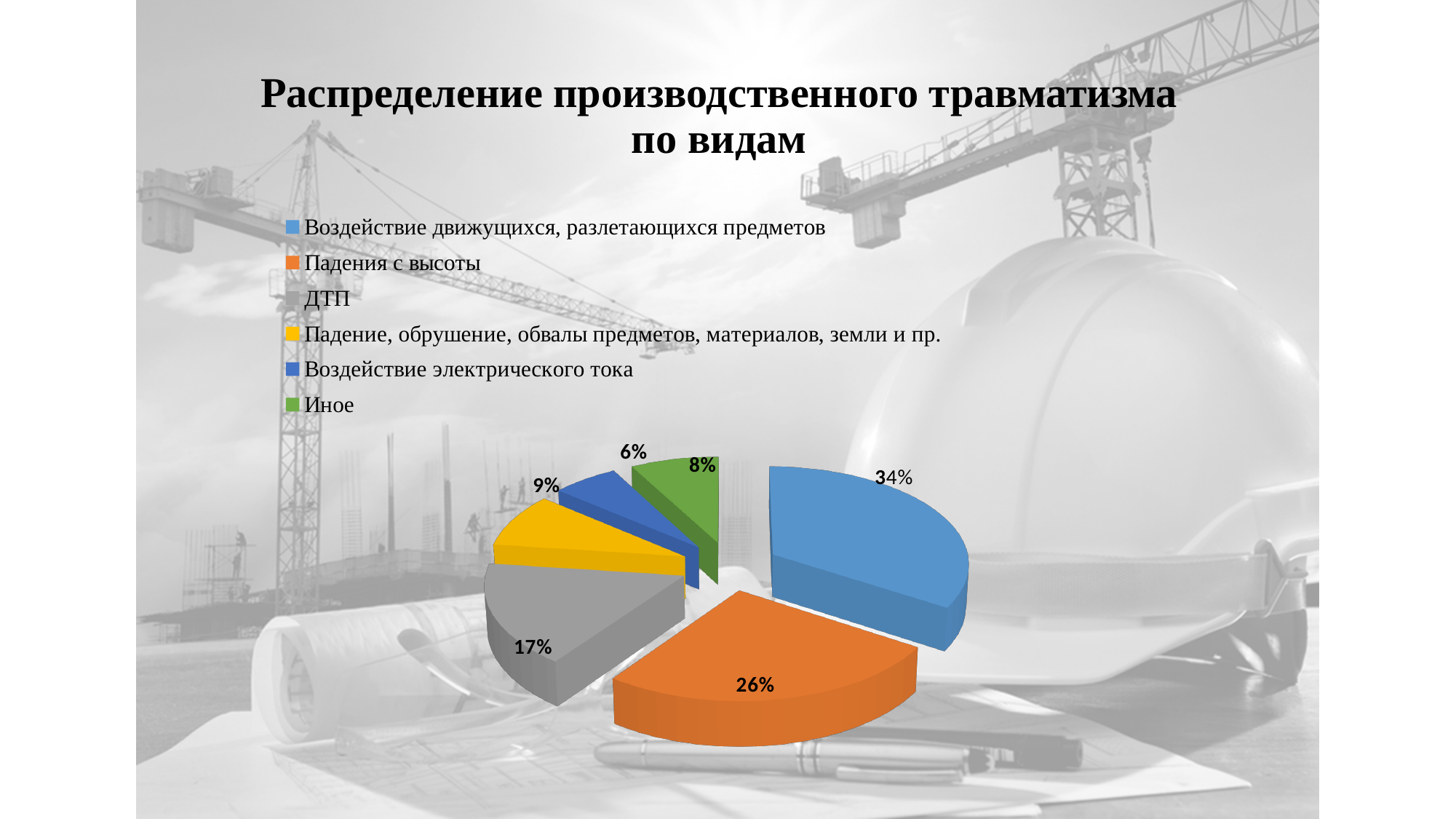
What kind of chart is shown on the slide? Pie chart What share of the pie is 'Воздействие электрического тока'? 6% What share of the pie is 'Иное'? 8% What share of the pie is 'ДТП'? 17% Which category has the smallest share of the pie? Воздействие электрического тока Which is larger: the share of 'Иное' or the share of 'Падение, обрушение, обвалы предметов, материалов, земли и пр.'? Падение, обрушение, обвалы предметов, материалов, земли и пр. Which category has the largest share of the pie? Воздействие движущихся, разлетающихся предметов How many categories does the legend list? 6 What is the difference between the shares of 'Падения с высоты' and 'ДТП'? 9% What is the title of the chart? Распределение производственного травматизма по видам What share of the pie is 'Падения с высоты'? 26% What share of the pie is 'Воздействие движущихся, разлетающихся предметов'? 34%